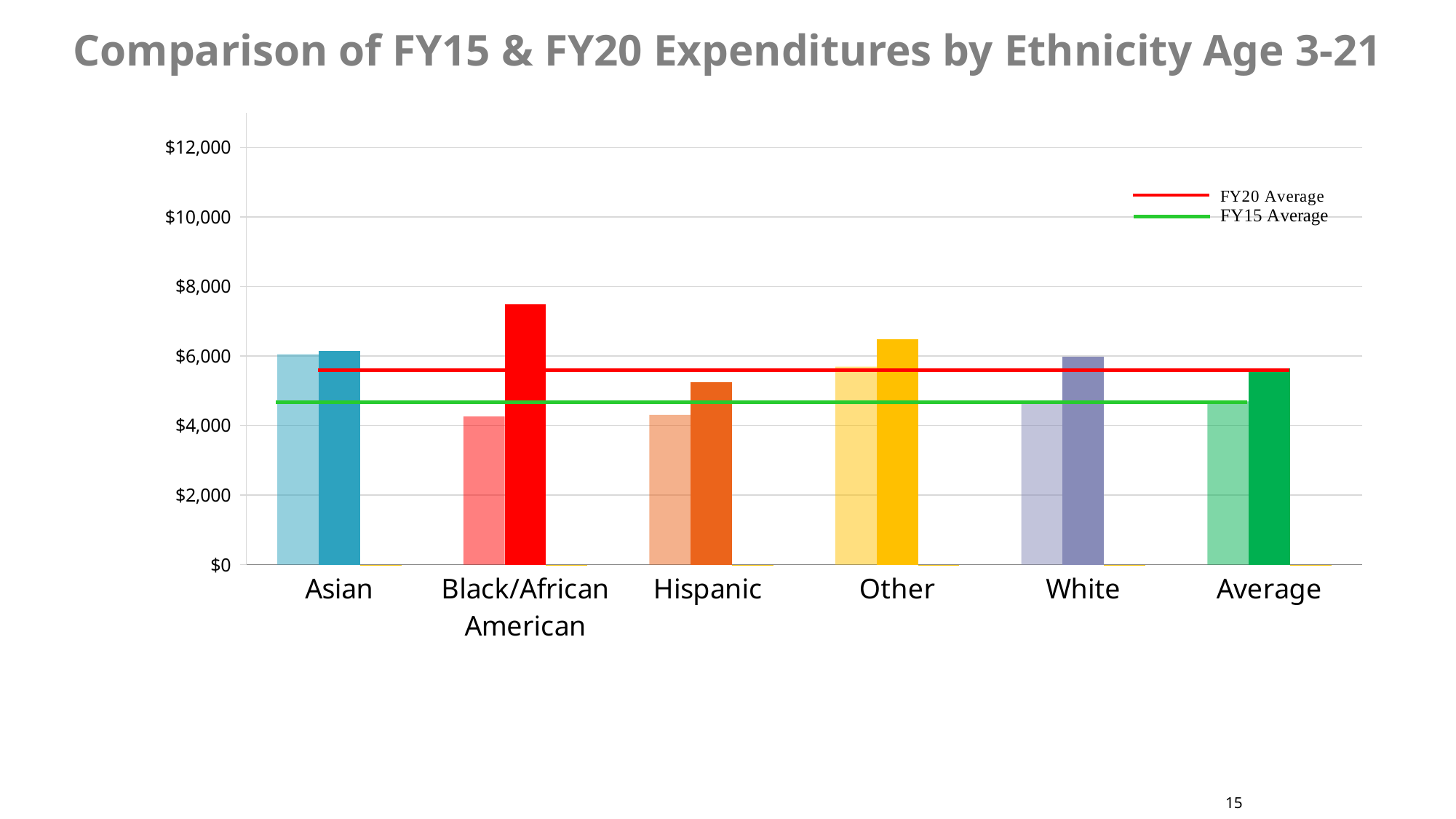
What kind of chart is shown on the slide? bar chart Which category has the tallest bar in the chart? Black/African American What colour is the FY15 Average line in the chart? green Is the shorter (lighter) bar for Hispanic greater or less than $6,000? less How many categories are shown along the x axis? 6 What colour is the FY20 Average line in the chart? red Is the taller (darker) bar for Other greater or less than $6,000? greater Is the shorter (lighter) bar for Asian greater or less than $4,000? greater Which is taller: the darker bar for Black/African American or the darker bar for Other? Black/African American How many entries does the legend list? 2